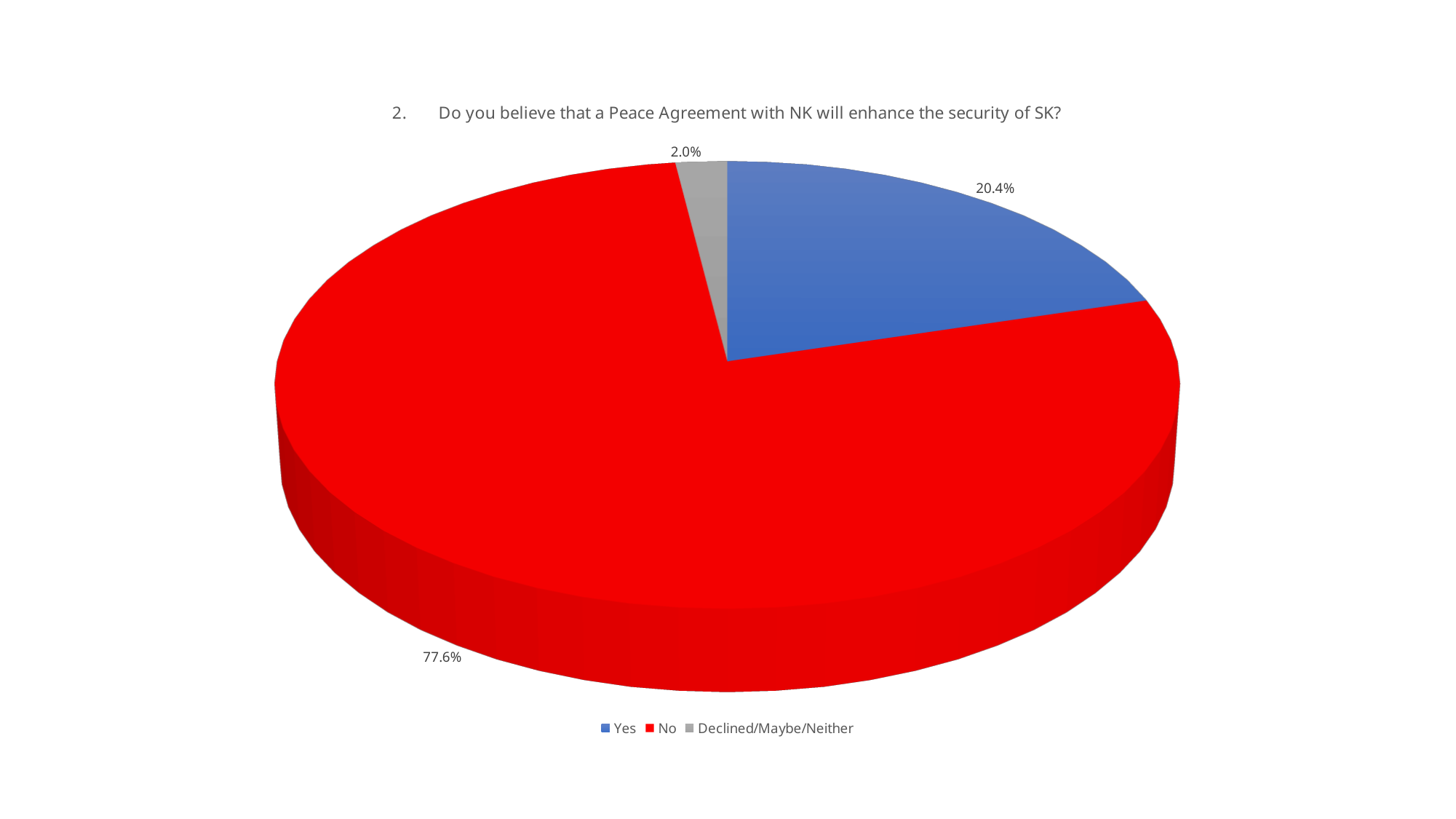
Which response has the smallest share of the pie? Declined/Maybe/Neither How many entries does the legend list? 3 What percentage of respondents answered "Yes"? 20.4% Which is larger, the share for "Yes" or the share for "Declined/Maybe/Neither"? Yes What colour represents the "No" response in the chart? Red How many categories does the pie chart show? 3 What is the title of the chart? 2. Do you believe that a Peace Agreement with NK will enhance the security of SK? What is the difference in percentage points between the "No" and "Yes" shares? 57.2 Which response has the largest share of the pie? No What percentage of respondents fall under "Declined/Maybe/Neither"? 2.0% What kind of chart is shown on the slide? Pie chart What percentage of respondents answered "No"? 77.6%